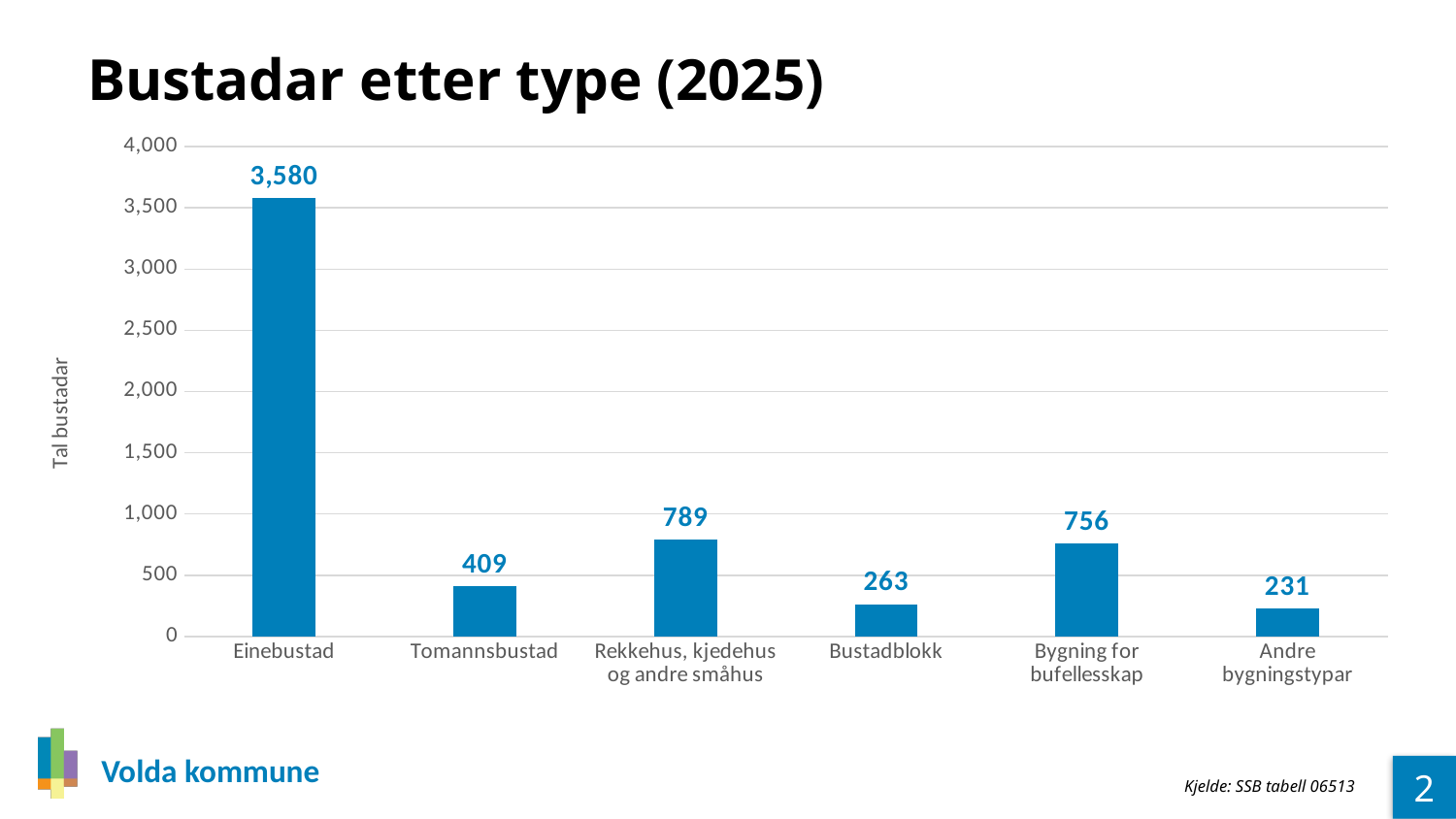
How many categories are shown on the x axis? 6 What kind of chart is shown on the slide? bar chart Which category has the highest value? Einebustad Which is larger, the value for Tomannsbustad or the value for Bustadblokk? Tomannsbustad What is the value for Einebustad? 3,580 What is the value for Bustadblokk? 263 What is the difference between the values for Rekkehus, kjedehus og andre småhus and Bygning for bufellesskap? 33 Is the value for Rekkehus, kjedehus og andre småhus greater or less than 500? greater What is the title of the chart? Bustadar etter type (2025) Which category has the lowest value? Andre bygningstypar What is the value for Tomannsbustad? 409 What is the value for Bygning for bufellesskap? 756